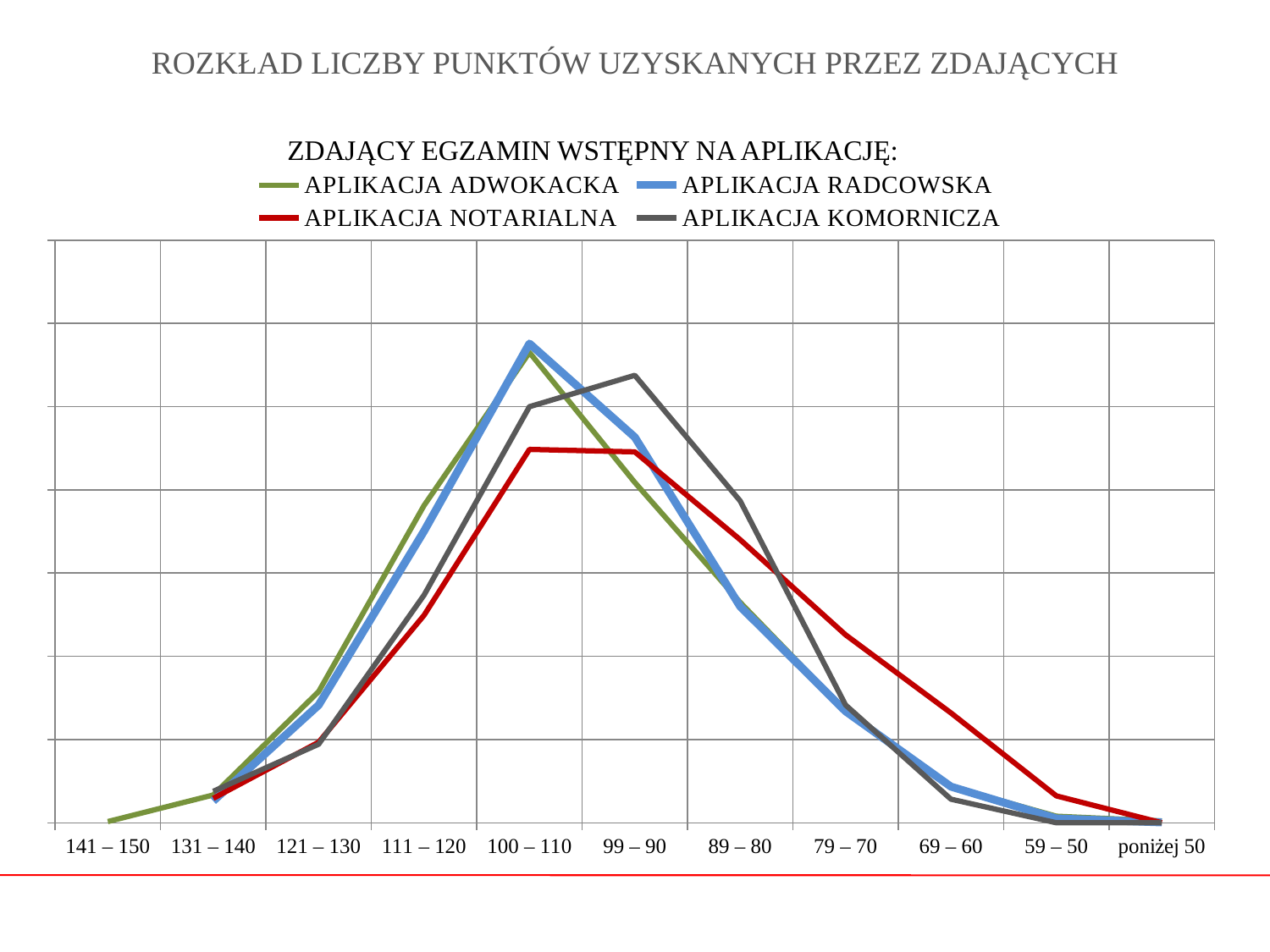
At the 89 – 80 score range, which series is higher: APLIKACJA KOMORNICZA or APLIKACJA ADWOKACKA? APLIKACJA KOMORNICZA In which score range does the APLIKACJA RADCOWSKA series reach its highest value? 100 – 110 How many series does the legend list? 4 At the 111 – 120 score range, which series is higher: APLIKACJA ADWOKACKA or APLIKACJA NOTARIALNA? APLIKACJA ADWOKACKA Which series has the lowest peak value? APLIKACJA NOTARIALNA In which score range does the APLIKACJA ADWOKACKA series reach its highest value? 100 – 110 Does the APLIKACJA RADCOWSKA series rise or fall from the 100 – 110 range to the poniżej 50 range? fall At the 79 – 70 score range, which series is higher: APLIKACJA NOTARIALNA or APLIKACJA RADCOWSKA? APLIKACJA NOTARIALNA What kind of chart is shown on the slide? line chart How many score-range categories are shown on the x axis? 11 In which score range does the APLIKACJA KOMORNICZA series reach its highest value? 99 – 90 What colour is the APLIKACJA NOTARIALNA line? red